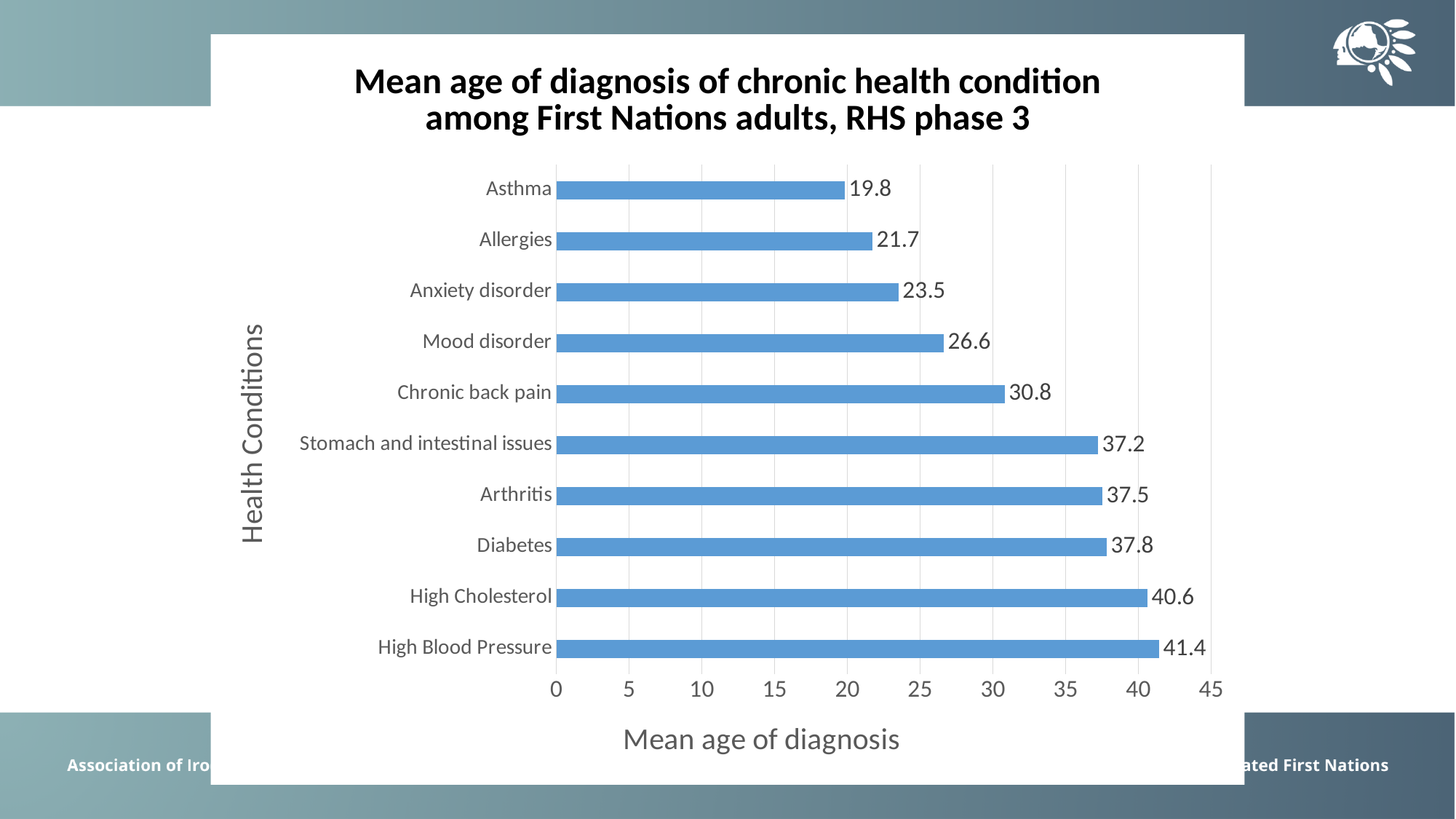
How many health conditions are shown in the chart? 10 What is the label of the horizontal axis? Mean age of diagnosis What is the mean age of diagnosis for Asthma? 19.8 Which health condition has the highest mean age of diagnosis? High Blood Pressure What is the difference in mean age of diagnosis between High Cholesterol and Mood disorder? 14 Which health condition has the lowest mean age of diagnosis? Asthma What kind of chart is shown on the slide? Bar chart Which has a higher mean age of diagnosis, Allergies or Anxiety disorder? Anxiety disorder What is the mean age of diagnosis for Diabetes? 37.8 What is the difference in mean age of diagnosis between High Blood Pressure and Asthma? 21.6 Is the mean age of diagnosis for Stomach and intestinal issues greater or less than 35? greater What is the mean age of diagnosis for Chronic back pain? 30.8